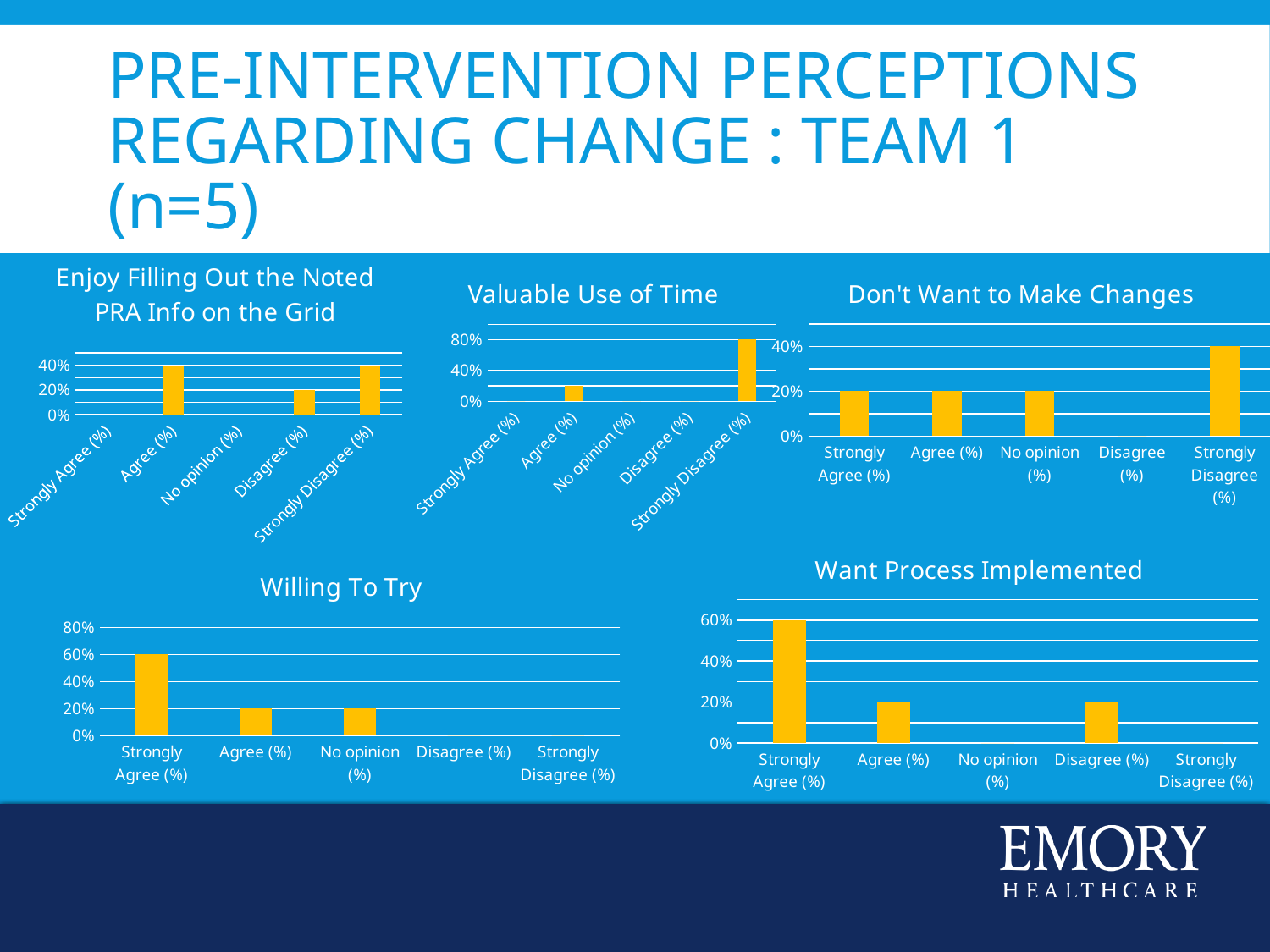
In the 'Want Process Implemented' chart, what is the value for Disagree (%)? 20% In the 'Want Process Implemented' chart, what is the difference between Strongly Agree (%) and Agree (%)? 40% In the 'Willing To Try' chart, which category has the highest value? Strongly Agree (%) In the 'Enjoy Filling Out the Noted PRA Info on the Grid' chart, what is the value for Disagree (%)? 20% In the 'Valuable Use of Time' chart, is the value for Agree (%) greater or less than 40%? less In the 'Don't Want to Make Changes' chart, which category has the highest value? Strongly Disagree (%) In the 'Don't Want to Make Changes' chart, what is the value for Strongly Disagree (%)? 40% In the 'Willing To Try' chart, which is larger, Strongly Agree (%) or No opinion (%)? Strongly Agree (%) How many charts are shown on the slide? 5 In the 'Valuable Use of Time' chart, what is the value for Strongly Disagree (%)? 80% In the 'Willing To Try' chart, what is the value for Strongly Agree (%)? 60% What type of chart is 'Want Process Implemented'? Bar chart